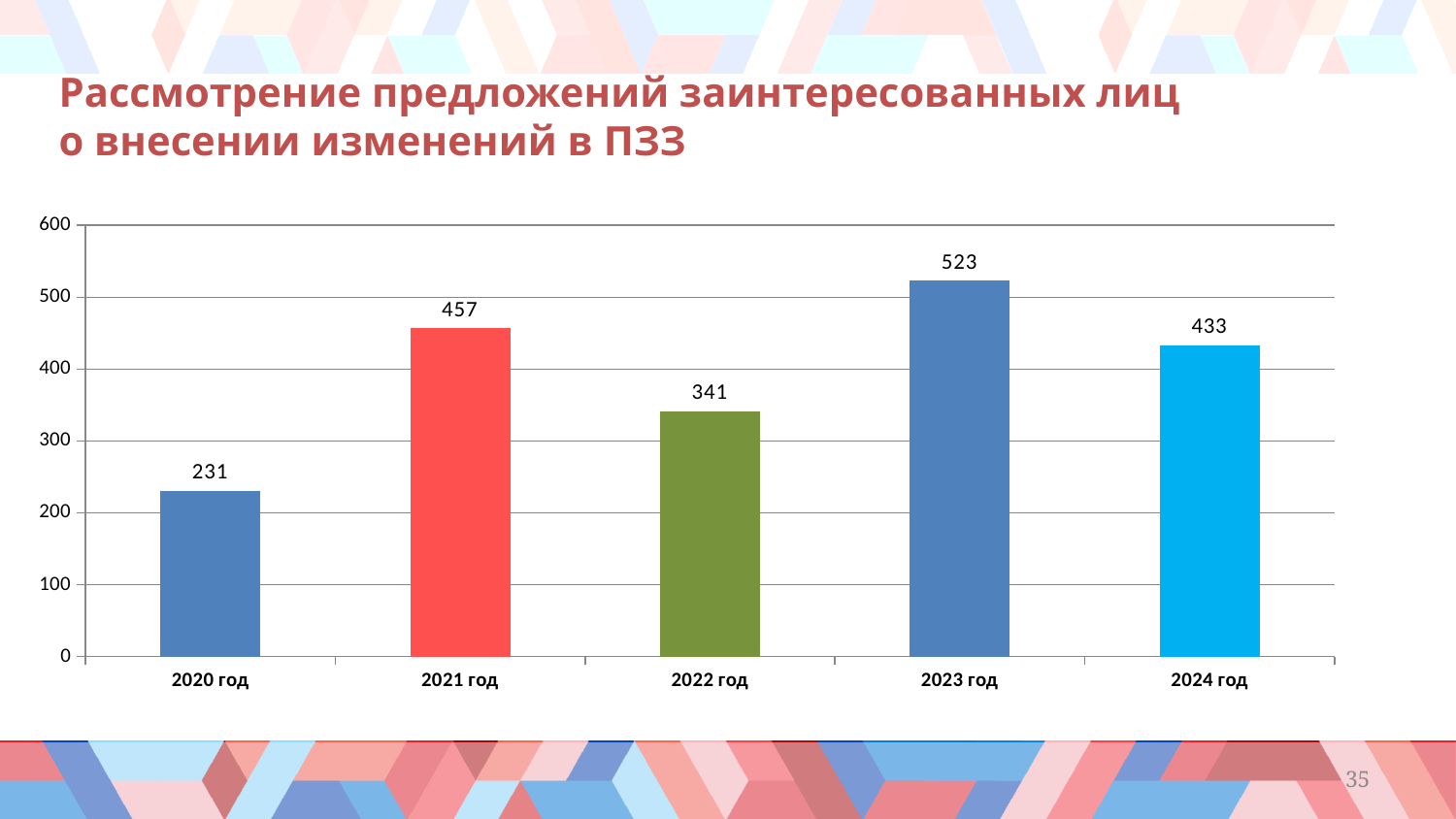
What is the difference between the values for 2023 год and 2024 год? 90 What is the value for 2022 год? 341 What is the value for 2024 год? 433 Which year has the lowest value? 2020 год Which year has the highest value? 2023 год What is the value for 2020 год? 231 What colour is the bar for 2021 год? red What kind of chart is shown on the slide? bar chart How many years are shown on the x axis? 5 What is the difference between the values for 2021 год and 2020 год? 226 Which is larger, the value for 2021 год or the value for 2024 год? 2021 год Is the value for 2022 год greater or less than 300? greater